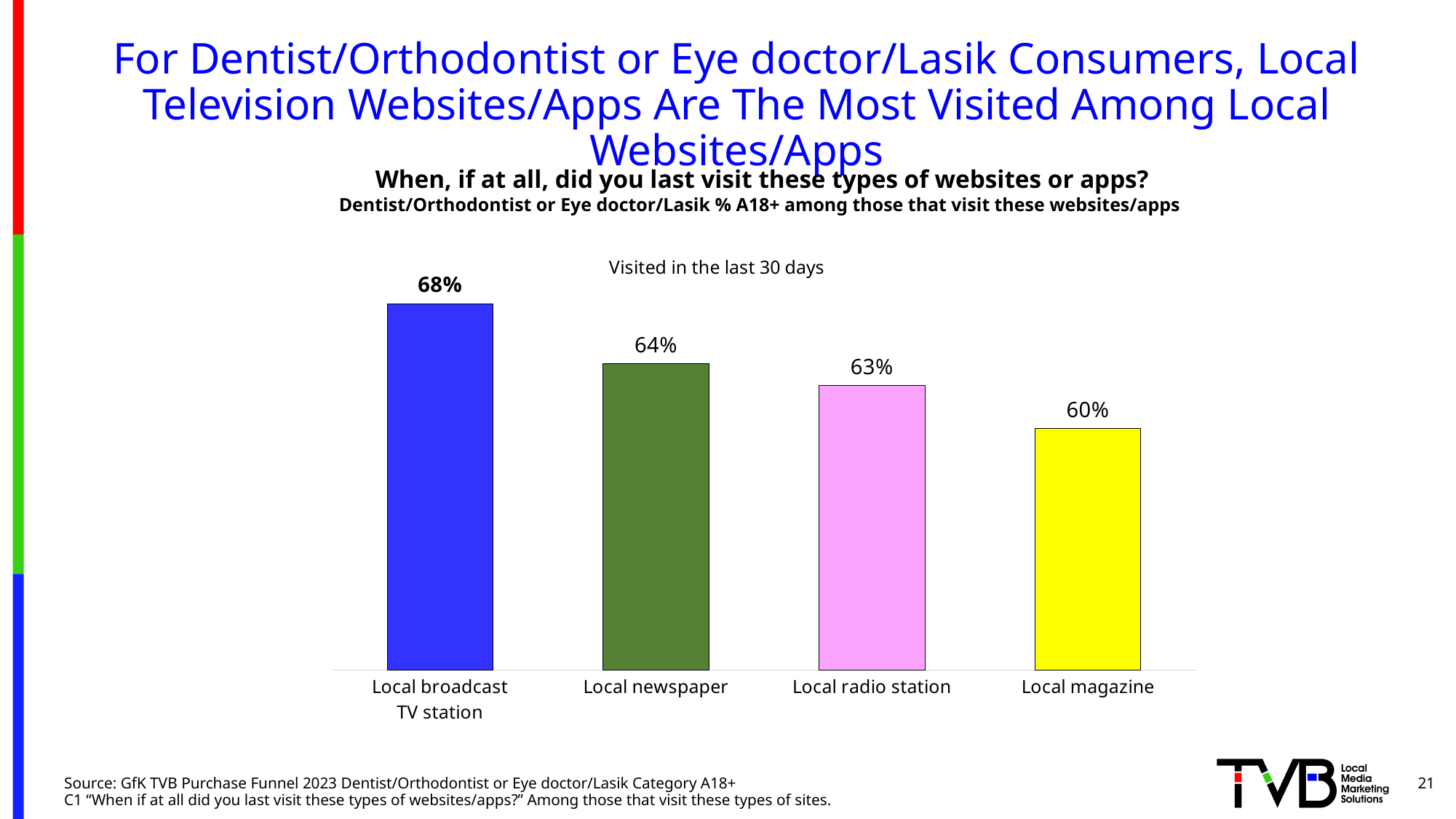
What is the value for Local newspaper? 64% How many categories are shown in the chart? 4 What is the value for Local broadcast TV station? 68% What is the difference between the values for Local broadcast TV station and Local magazine? 8% What kind of chart is shown on the slide? Bar chart What is the value for Local radio station? 63% What is the title shown above the bars in the chart? Visited in the last 30 days What is the value for Local magazine? 60% Which category has the lowest value? Local magazine Which category has the highest value? Local broadcast TV station What is the difference between the values for Local newspaper and Local radio station? 1% Which is larger, the value for Local newspaper or the value for Local magazine? Local newspaper